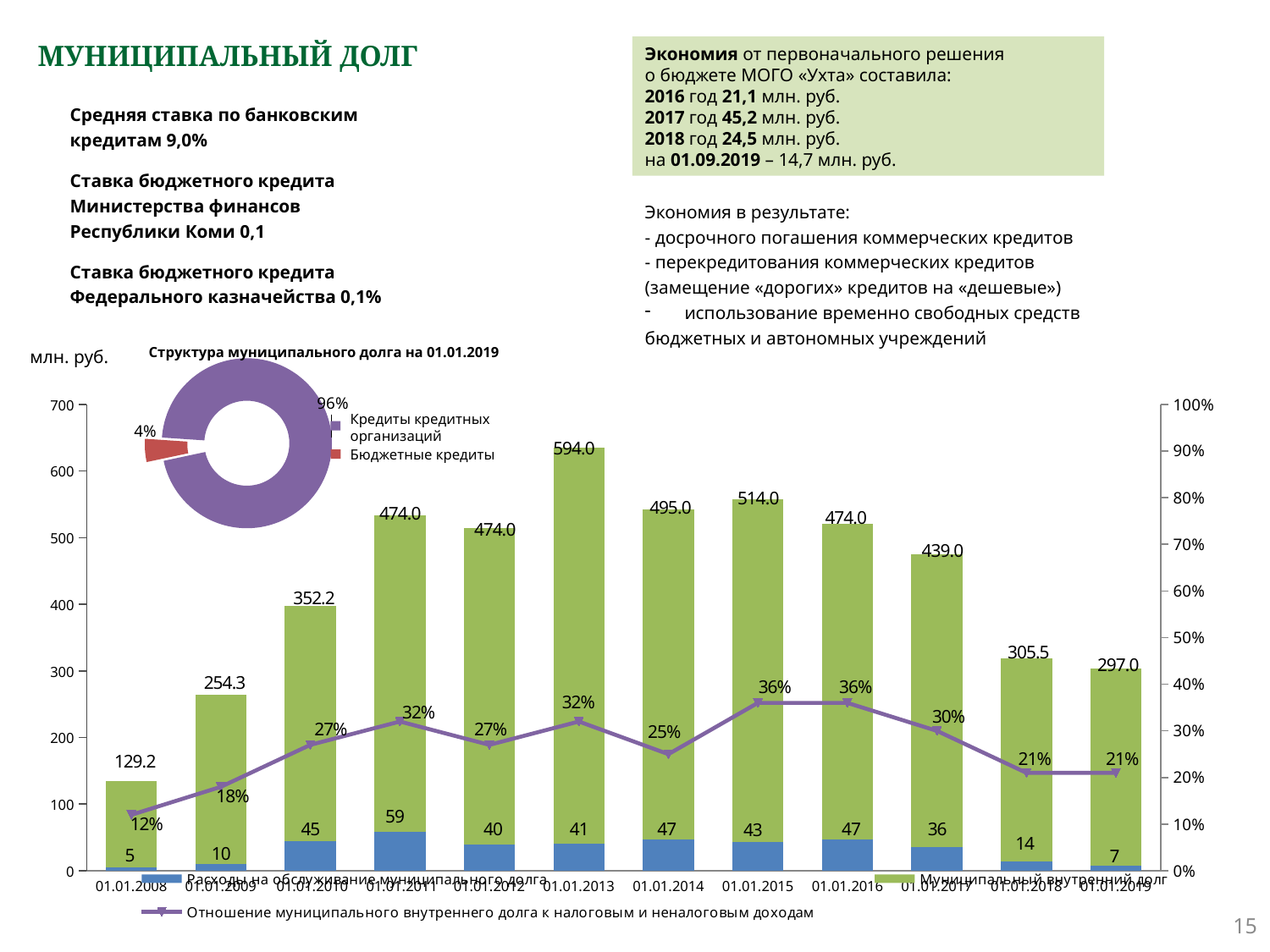
How many dates are shown on the x axis of the main bar chart? 12 In the doughnut chart 'Структура муниципального долга на 01.01.2019', what share do Кредиты кредитных организаций have? 96% In the main bar chart, on which date is Муниципальный внутренний долг the highest? 01.01.2013 In the main bar chart, what is the difference between Муниципальный внутренний долг on 01.01.2013 and on 01.01.2019? 297.0 In the main bar chart, what is the value of the line 'Отношение муниципального внутреннего долга к налоговым и неналоговым доходам' on 01.01.2015? 36% In the main bar chart, which date has the larger Муниципальный внутренний долг: 01.01.2009 or 01.01.2018? 01.01.2018 In the main bar chart, on which date is Муниципальный внутренний долг the lowest? 01.01.2008 In the main bar chart, what is the value of Расходы на обслуживание муниципального долга on 01.01.2011? 59 How many series does the legend of the main bar chart list? 3 In the main bar chart, does Муниципальный внутренний долг rise or fall from 01.01.2016 to 01.01.2019? fall In the main bar chart, what is the value of Муниципальный внутренний долг on 01.01.2013? 594.0 In the doughnut chart 'Структура муниципального долга на 01.01.2019', what share do Бюджетные кредиты have? 4%